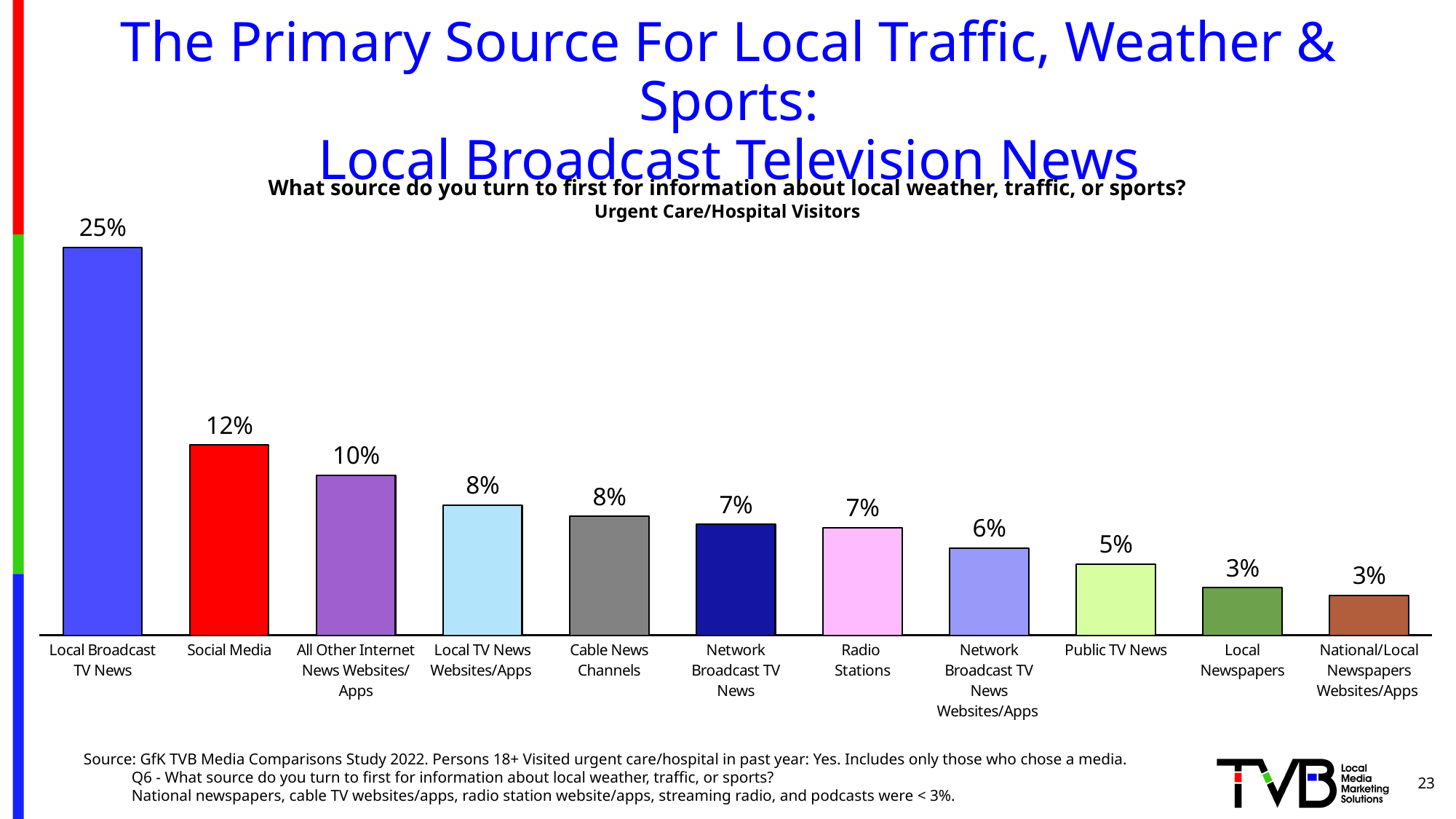
What is the value shown for Public TV News? 5% What percentage of urgent care/hospital visitors turn first to Local Broadcast TV News for local weather, traffic, or sports? 25% What kind of chart is shown on the slide? Bar chart What is the value shown for Radio Stations? 7% Do the values rise or fall moving from left to right across the chart? Fall What is the difference between the values for All Other Internet News Websites/Apps and Local Newspapers? 7% What is the value shown for Social Media? 12% What is the difference between the values for Local Broadcast TV News and Social Media? 13% Which group of respondents does the chart describe, according to the subtitle? Urgent Care/Hospital Visitors How many sources (bars) are shown on the chart? 11 Which source has the highest value on the chart? Local Broadcast TV News Which is larger, the value for Cable News Channels or the value for Network Broadcast TV News Websites/Apps? Cable News Channels